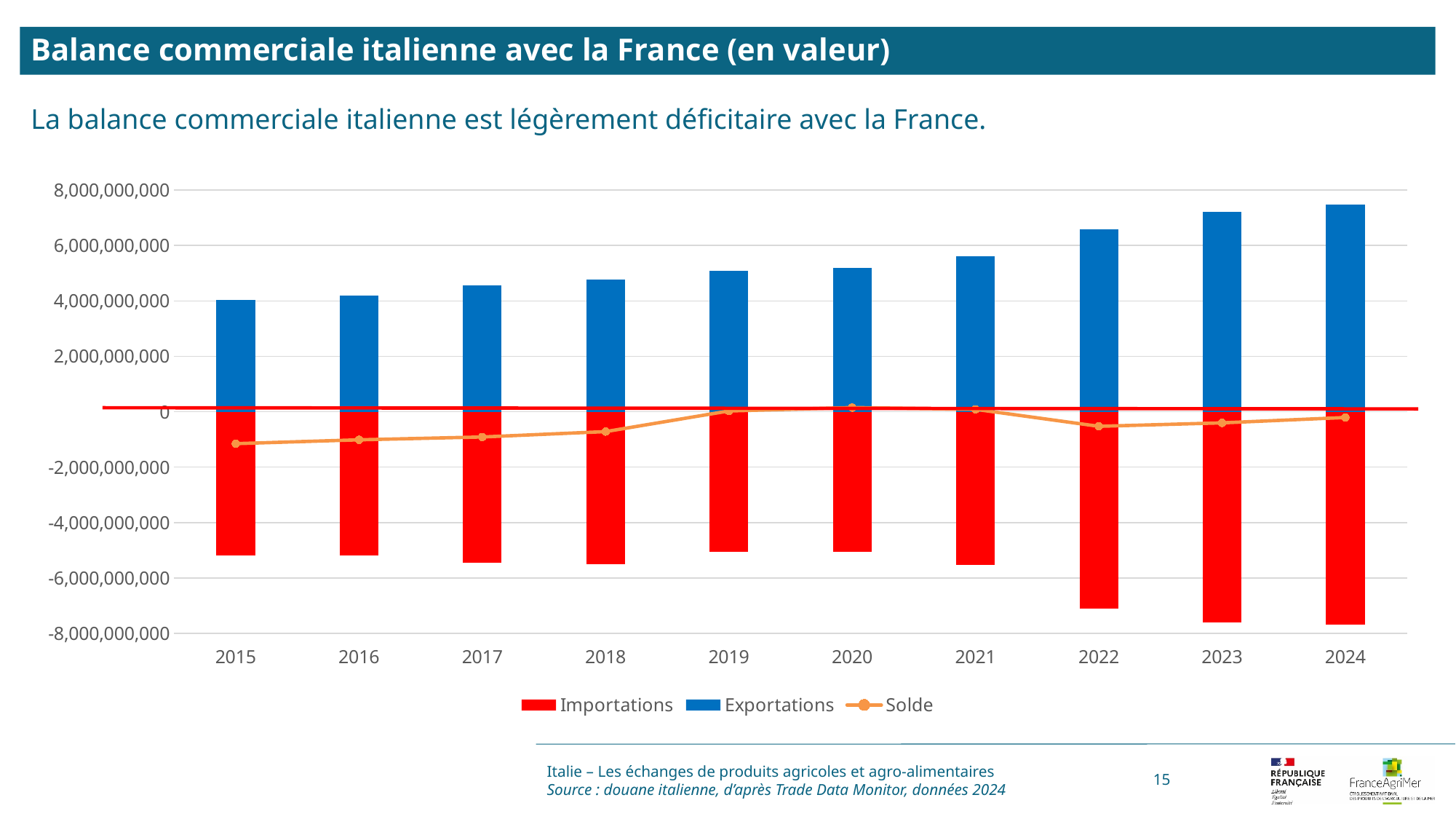
Which year has the highest Exportations value? 2024 How many years are shown on the x axis of the chart? 10 Which year has the lowest Solde value? 2015 How many series does the chart legend list? 3 Is the Exportations value for 2024 greater or less than 6,000,000,000? greater Do the Exportations values rise or fall from 2015 to 2024? Rise Is the Importations value for 2022 greater or less than -6,000,000,000? less Is the Solde value for 2015 greater or less than 0? less Which series is drawn as an orange line with markers? Solde Which year has the lowest Exportations value? 2015 What kind of chart is used for the Importations and Exportations series? Bar chart